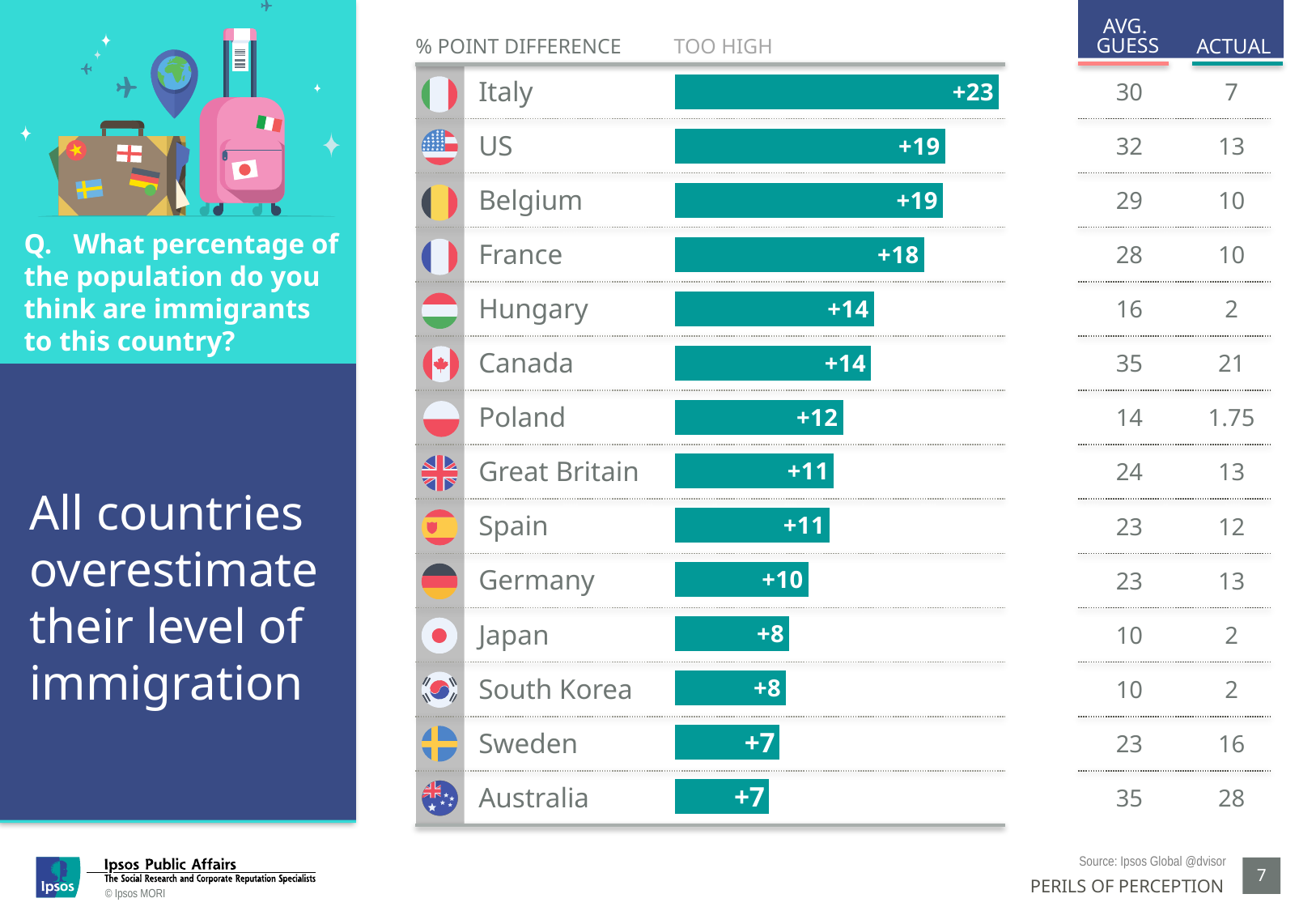
What kind of chart is used to show the % point difference? Bar chart What is the % point difference shown for Italy? +23 What is the difference between the % point difference for Italy and for Australia? 16 Which countries share the lowest % point difference in the chart? Sweden and Australia Do the bar values increase or decrease going from the top of the chart to the bottom? Decrease What is the difference between the % point difference for US and for Poland? 7 What is the % point difference shown for Germany? +10 What is the % point difference shown for Great Britain? +11 What is the % point difference shown for Hungary? +14 Which has a larger % point difference, France or Hungary? France How many countries are shown in the bar chart? 14 Which country has the highest % point difference in the chart? Italy